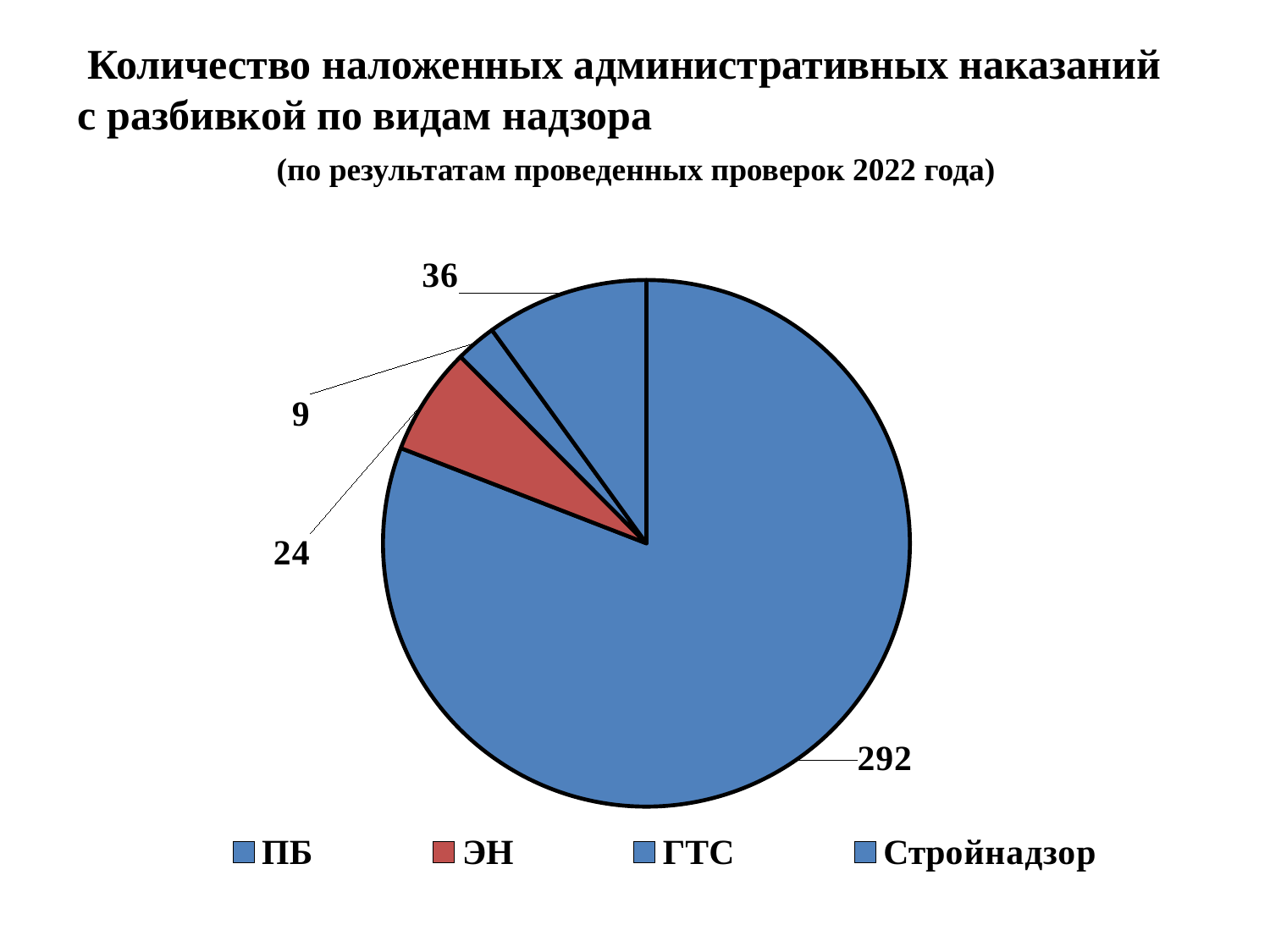
What is the difference between the largest slice (292) and the slice labelled 36? 256 What kind of chart is shown on the slide? pie chart What colour is the ЭН slice in the pie chart? red What value is shown for the red slice (ЭН) in the pie chart? 24 What is the difference between the slice labelled 36 and the red slice labelled 24? 12 What is the value of the smallest slice in the pie chart? 9 How many entries does the legend of the pie chart list? 4 What is the value of the largest slice in the pie chart? 292 According to the subtitle, the results of inspections from which year does the chart show? 2022 How many slices does the pie chart have? 4 Which is larger: the slice labelled 36 or the red slice labelled 24? 36 What is the total of all slice values in the pie chart? 361